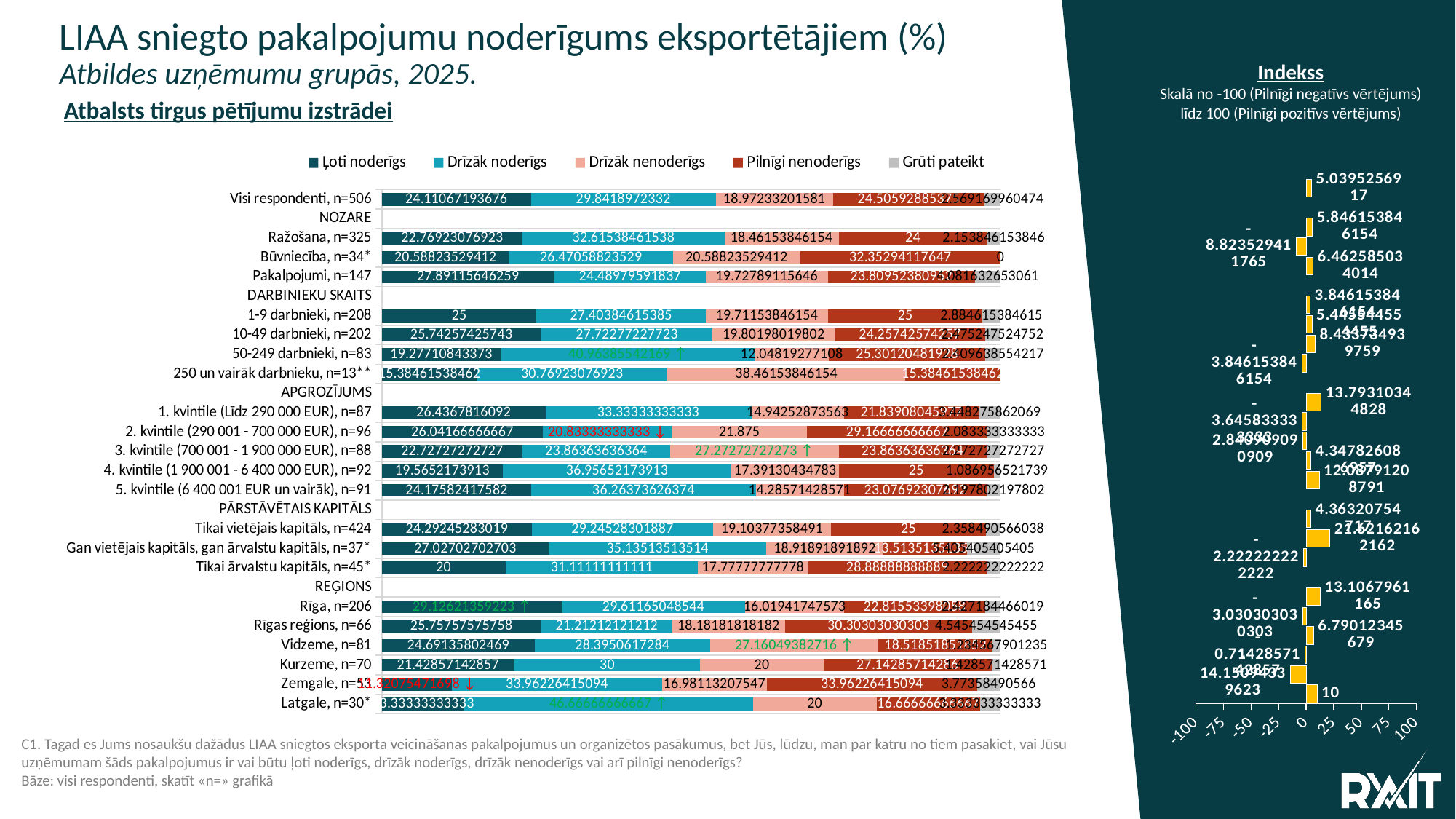
What is the title of the index chart on the right side of the slide? Indekss In the main chart, what is the 'Grūti pateikt' value for Būvniecība, n=34*? 0 In the main chart, which is larger for Kurzeme, n=70: the 'Drīzāk noderīgs' value or the 'Drīzāk nenoderīgs' value? Drīzāk noderīgs In the main chart, what is the 'Pilnīgi nenoderīgs' value for Ražošana, n=325? 24 In the main chart, what is the 'Drīzāk noderīgs' value for Kurzeme, n=70? 30 How many series does the legend of the main chart list? 5 In the main chart, what is the difference between the 'Drīzāk noderīgs' value (30) and the 'Drīzāk nenoderīgs' value (20) for Kurzeme, n=70? 10 In the main chart, what is the 'Ļoti noderīgs' value for 1-9 darbinieki, n=208? 25 What kind of chart is the main chart on the slide? stacked bar chart In the main chart, what is the 'Drīzāk nenoderīgs' value for Latgale, n=30*? 20 In the main chart, what is the 'Drīzāk nenoderīgs' value for 2. kvintile (290 001 - 700 000 EUR), n=96? 21.875 In the main chart, what is the 'Ļoti noderīgs' value for Tikai ārvalstu kapitāls, n=45*? 20